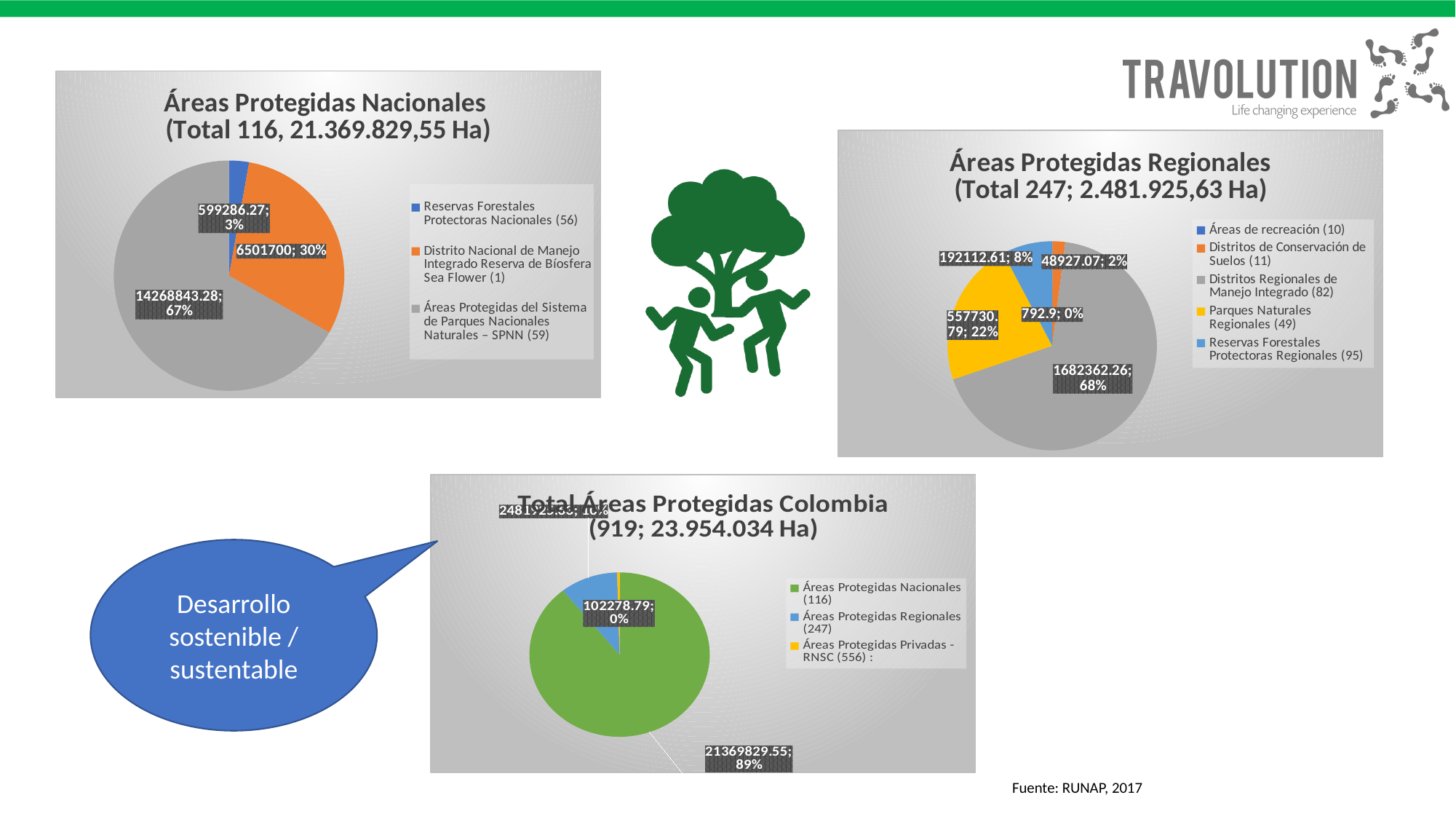
In the 'Áreas Protegidas Nacionales' chart, what value is labelled for Distrito Nacional de Manejo Integrado Reserva de Bíosfera Sea Flower (1)? 6501700 In the 'Áreas Protegidas Nacionales' chart, which category has the smallest slice? Reservas Forestales Protectoras Nacionales (56) In the 'Áreas Protegidas Nacionales' chart, what share of the pie is Áreas Protegidas del Sistema de Parques Nacionales Naturales – SPNN (59)? 67% How many categories does the legend of the 'Áreas Protegidas Regionales' chart list? 5 In the 'Total Áreas Protegidas Colombia' chart, what value is labelled for Áreas Protegidas Privadas - RNSC (556)? 102278.79 In the 'Áreas Protegidas Regionales' chart, what value is labelled for Parques Naturales Regionales (49)? 557730.79 What kind of chart is 'Áreas Protegidas Nacionales'? Pie chart How many series does the legend of the 'Total Áreas Protegidas Colombia' chart list? 3 In the 'Áreas Protegidas Regionales' chart, which is larger: Reservas Forestales Protectoras Regionales (95) or Distritos de Conservación de Suelos (11)? Reservas Forestales Protectoras Regionales (95) In the 'Áreas Protegidas Regionales' chart, which category has the largest slice? Distritos Regionales de Manejo Integrado (82) In the 'Total Áreas Protegidas Colombia' chart, what share of the pie is Áreas Protegidas Nacionales (116)? 89% In the 'Áreas Protegidas Regionales' chart, what share of the pie is Distritos Regionales de Manejo Integrado (82)? 68%